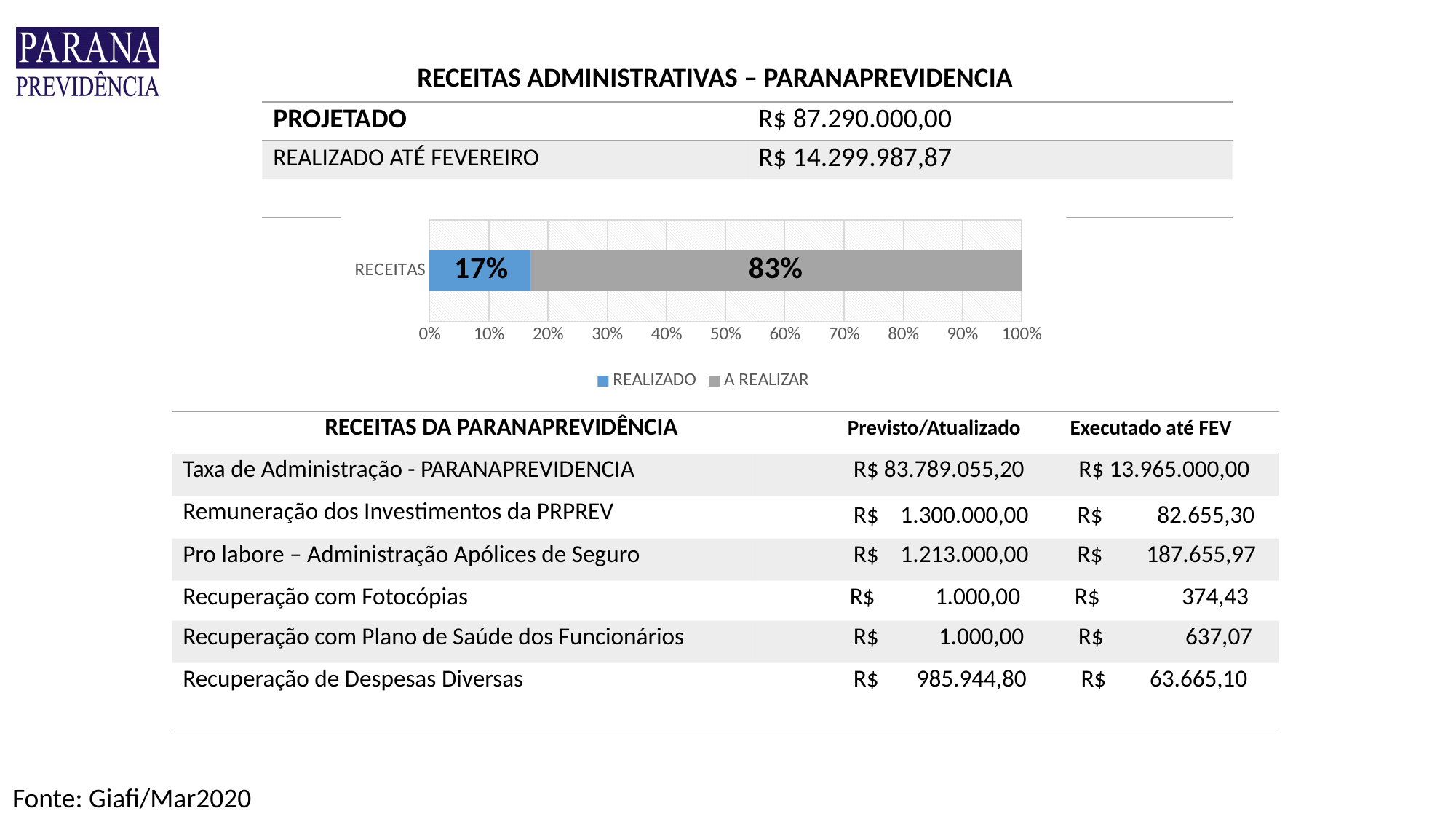
How many categories are plotted on the chart? 1 Is the REALIZADO value for RECEITAS greater or less than 20%? less What is the total of the stacked bar for RECEITAS? 100% Which series has the larger value for RECEITAS, REALIZADO or A REALIZAR? A REALIZAR Is the A REALIZAR value for RECEITAS greater or less than 80%? greater What kind of chart is shown on the slide? bar chart What is the value of the A REALIZAR series for RECEITAS? 83% What is the label of the category shown on the chart's vertical axis? RECEITAS Which colour represents the REALIZADO series in the chart? blue How many series does the chart legend list? 2 What is the difference between the A REALIZAR and REALIZADO values for RECEITAS? 66% What is the value of the REALIZADO series for RECEITAS? 17%